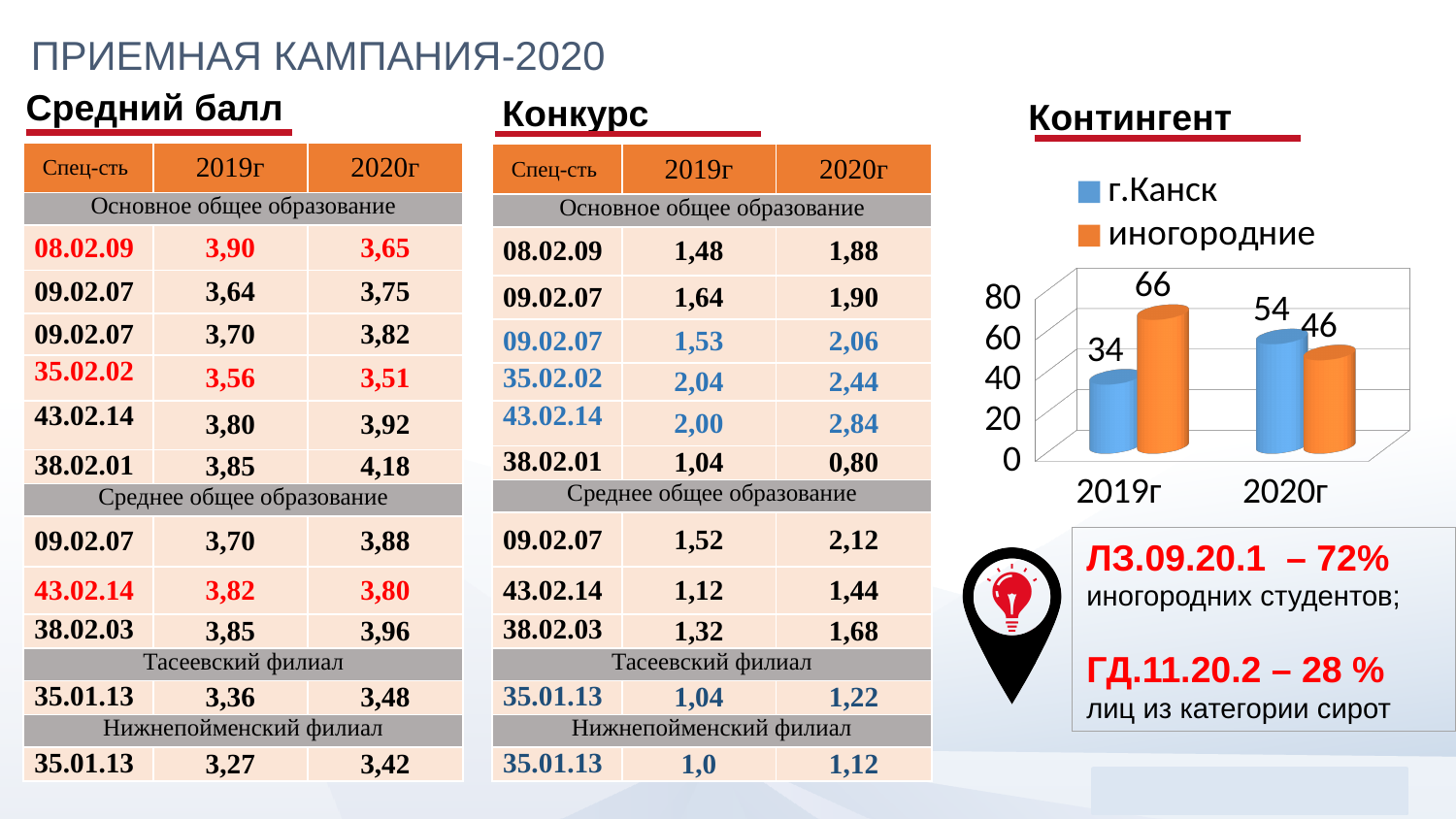
In the "Контингент" chart, what is the value for иногородние in 2019г? 66 In the "Контингент" chart, what is the value for г.Канск in 2019г? 34 In the "Контингент" chart, what is the difference between иногородние and г.Канск in 2019г? 32 In the "Контингент" chart, what is the value for г.Канск in 2020г? 54 In the "Контингент" chart, which colour represents the series г.Канск? blue How many series does the legend of the "Контингент" chart list? 2 In the "Контингент" chart, what is the value for иногородние in 2020г? 46 What kind of chart is shown under the heading "Контингент"? bar chart In the "Контингент" chart, does the value for иногородние rise or fall from 2019г to 2020г? fall In the "Контингент" chart, which series has the highest value in 2019г? иногородние In the "Контингент" chart, is the value for г.Канск larger in 2019г or in 2020г? 2020г How many categories are shown on the x axis of the "Контингент" chart? 2